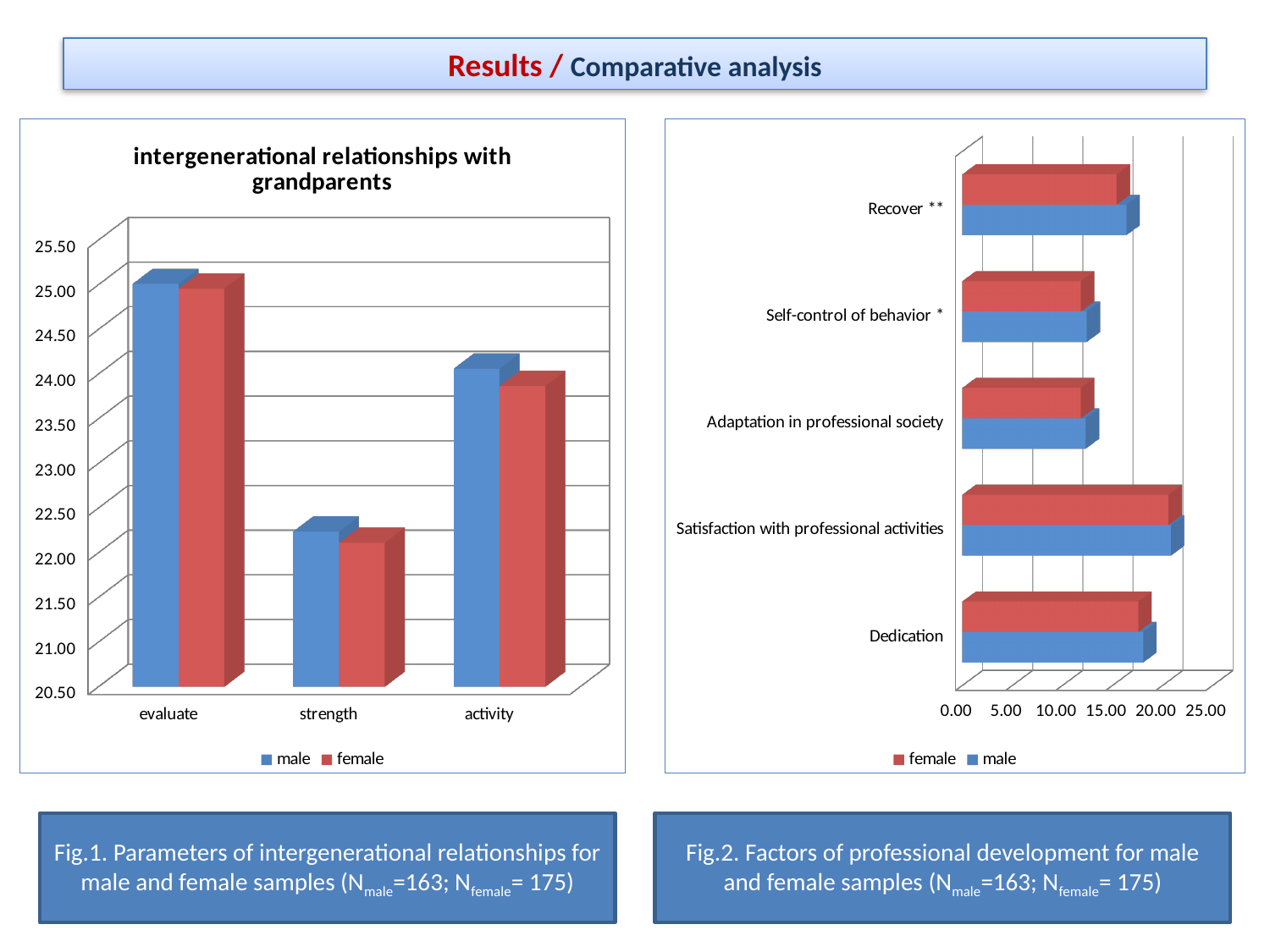
In the left chart titled 'intergenerational relationships with grandparents', is the male value for strength greater or less than 23.00? less In the left chart titled 'intergenerational relationships with grandparents', which category has the highest value for male? evaluate In the left chart titled 'intergenerational relationships with grandparents', which is larger for male: strength or activity? activity In the left chart titled 'intergenerational relationships with grandparents', which category has the lowest value for female? strength How many series does the legend of the left chart titled 'intergenerational relationships with grandparents' list? 2 How many categories are shown on the x axis of the left chart titled 'intergenerational relationships with grandparents'? 3 In the right chart (Fig.2), is the male value for Adaptation in professional society greater or less than 15.00? less In the left chart titled 'intergenerational relationships with grandparents', is the female value for activity greater or less than 23.00? greater What type of chart is the left chart titled 'intergenerational relationships with grandparents'? bar chart In the right chart (Fig.2), which category has the highest value for female? Satisfaction with professional activities How many categories are shown on the right chart (Fig.2)? 5